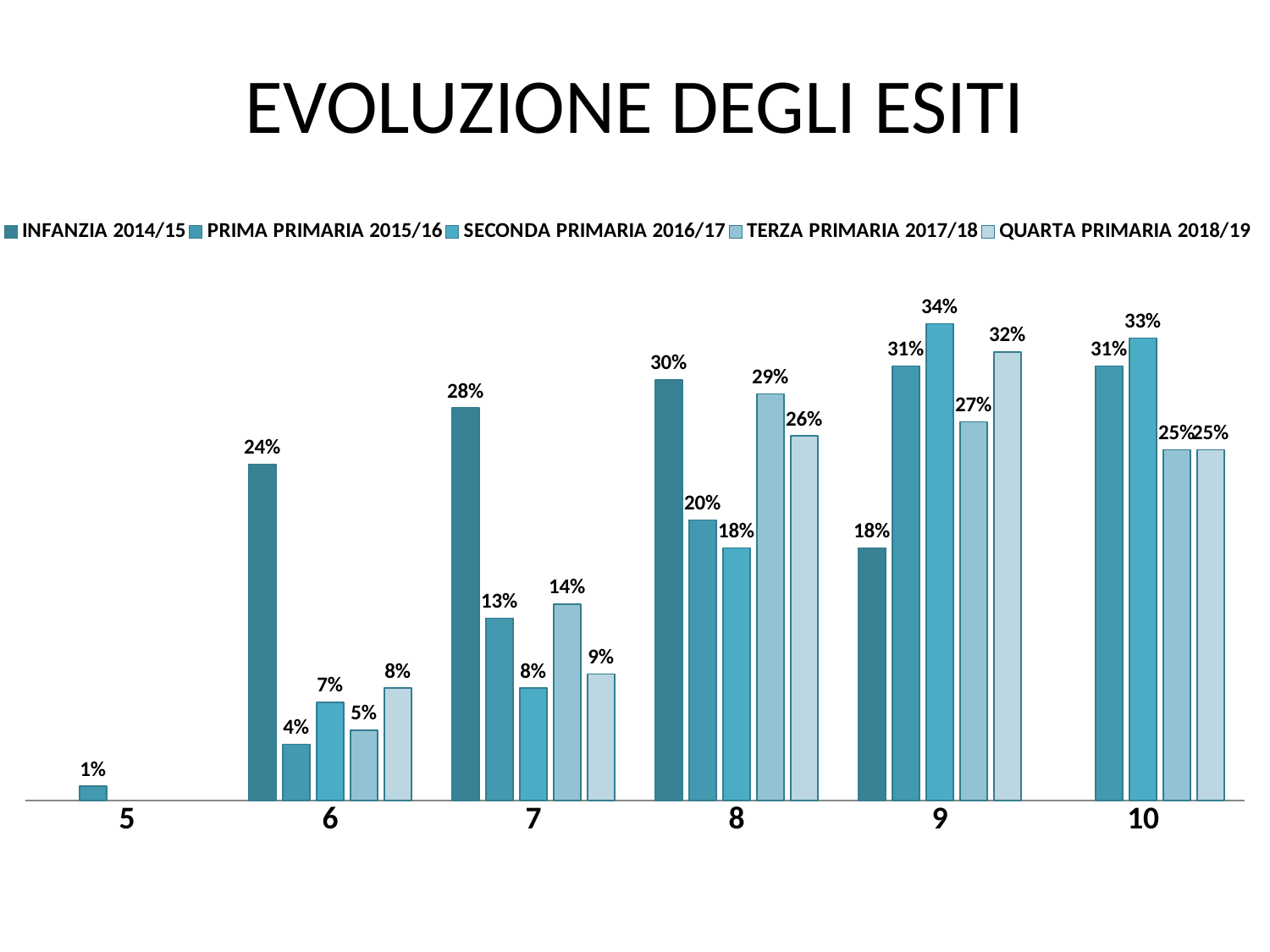
What is the difference between INFANZIA 2014/15 and PRIMA PRIMARIA 2015/16 at category 6? 20 percentage points At category 8, which is larger: TERZA PRIMARIA 2017/18 or QUARTA PRIMARIA 2018/19? TERZA PRIMARIA 2017/18 Which series has the lowest value at category 6? PRIMA PRIMARIA 2015/16 What kind of chart is shown on the slide? Bar chart How many categories are shown on the x axis? 6 Which series has the highest value at category 9? SECONDA PRIMARIA 2016/17 What is the value for INFANZIA 2014/15 at category 8? 30% What is the value for QUARTA PRIMARIA 2018/19 at category 7? 9% What is the only value shown for category 5? 1% What is the value for SECONDA PRIMARIA 2016/17 at category 9? 34% What is the title of the chart? EVOLUZIONE DEGLI ESITI How many series does the legend list? 5